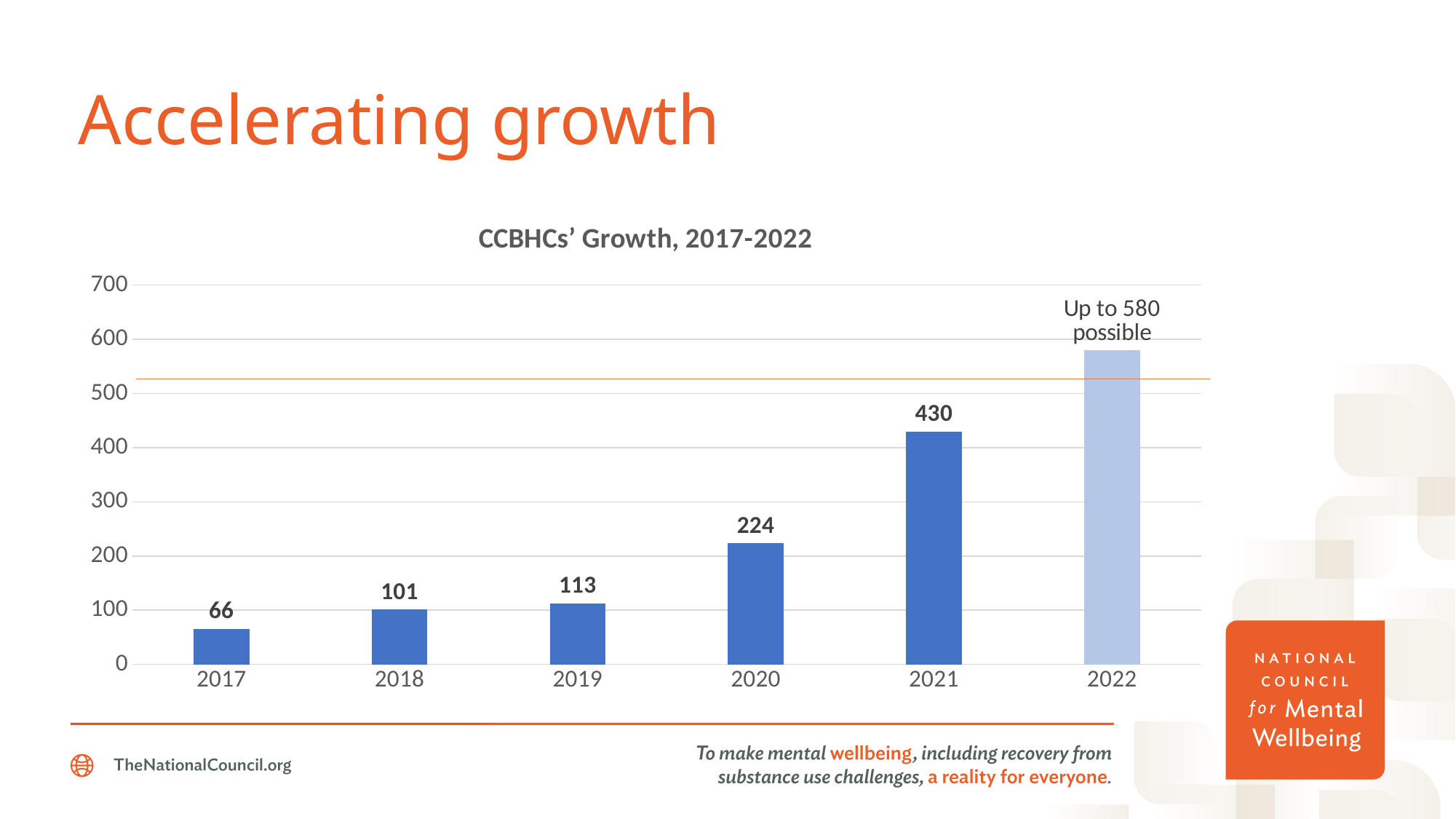
What is the title of the chart? CCBHCs' Growth, 2017-2022 What label is shown above the 2022 bar? Up to 580 possible Which is larger, the value for 2019 or the value for 2020? 2020 Which year has the tallest bar? 2022 How many years are shown on the x axis? 6 What is the difference between the values for 2021 and 2020? 206 What kind of chart is this? bar chart What is the value for 2017? 66 What is the value for 2020? 224 Which year has the lowest value? 2017 What is the difference between the values for 2019 and 2018? 12 What is the value for 2021? 430